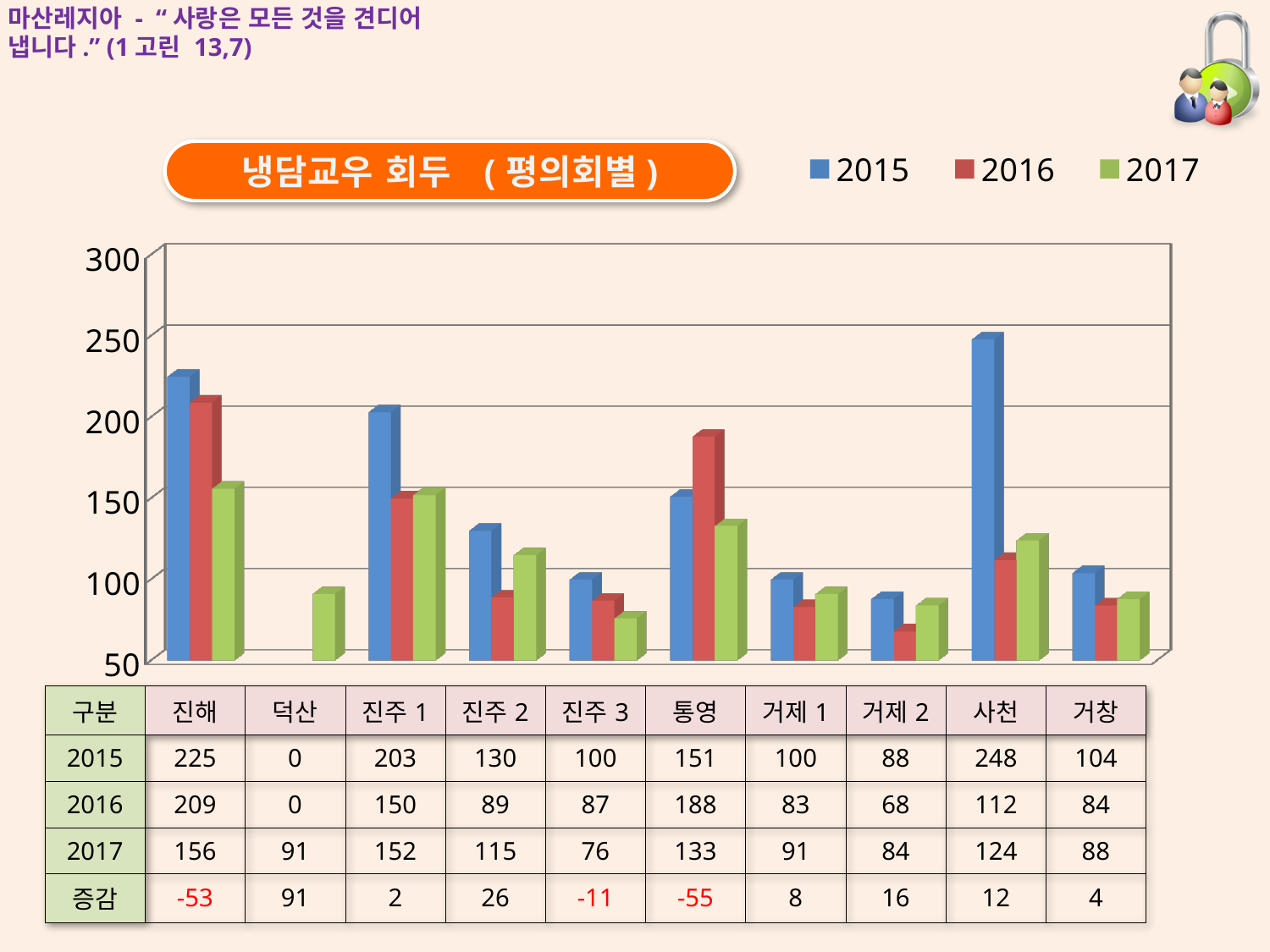
Which is larger for 통영: the 2015 value or the 2016 value? 2016 What is the 2015 value for 사천? 248 What is the title shown in the orange box above the chart? 냉담교우 회두 ( 평의회별 ) What is the 2016 value for 통영? 188 How many categories are shown along the x axis of the chart? 10 Which category has the lowest 2017 value? 진주 3 What is the 2017 value for 덕산? 91 Which category has the highest 2015 value? 사천 What kind of chart is shown on the slide? bar chart Is the 2015 value for 진주 1 greater or less than 200? greater What is the difference between the 2015 and 2017 values for 진해? 69 How many series does the legend list? 3